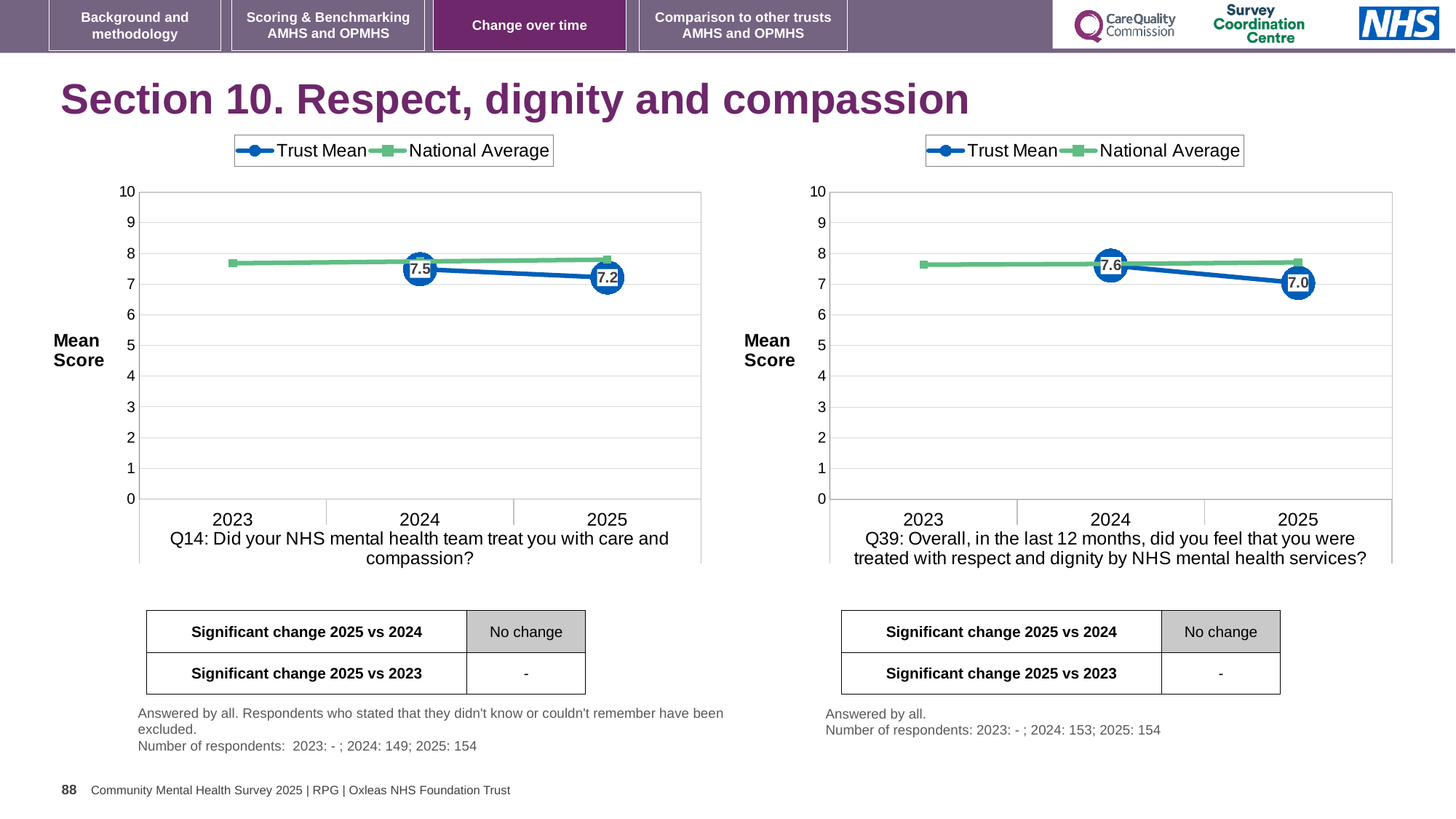
How many series does the legend of the right chart (Q39) list? 2 On the left chart (Q14), which year has the higher Trust Mean, 2024 or 2025? 2024 On the left chart (Q14), what is the Trust Mean value for 2024? 7.5 On the left chart (Q14), what is the Trust Mean value for 2025? 7.2 What kind of chart is the left chart (Q14)? line chart On the left chart (Q14), by how much did the Trust Mean fall from 2024 to 2025? 0.3 On the right chart (Q39), what is the Trust Mean value for 2024? 7.6 On the right chart (Q39), does the Trust Mean rise or fall from 2024 to 2025? fall How many years are shown on the x axis of the left chart (Q14)? 3 On the right chart (Q39), what is the Trust Mean value for 2025? 7.0 On the right chart (Q39), what is the difference between the Trust Mean in 2024 and in 2025? 0.6 On the right chart (Q39), is the National Average value for 2023 greater or less than 7? greater